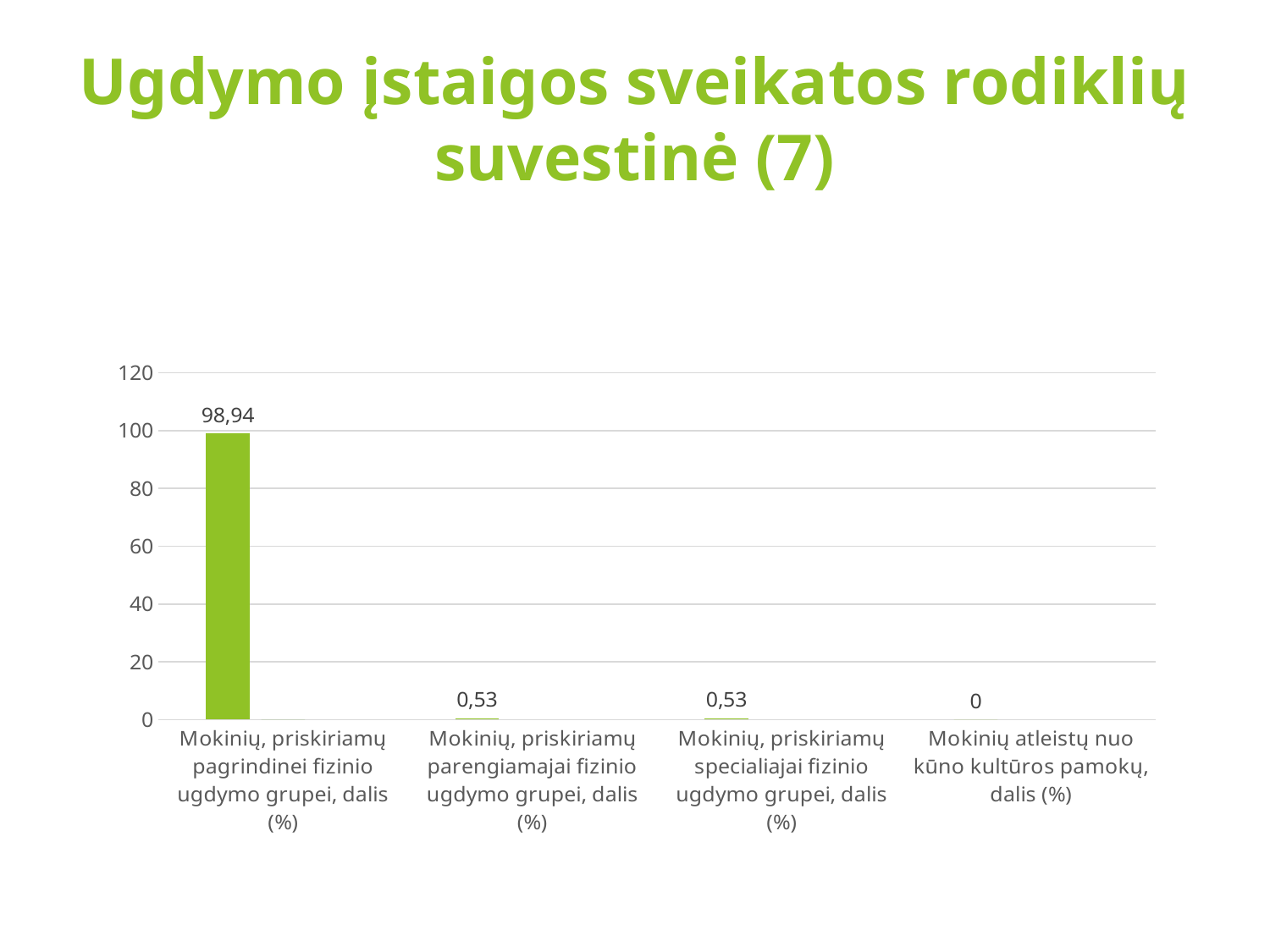
How many categories are shown on the x axis of the chart? 4 Which category has the lowest value? Mokinių atleistų nuo kūno kultūros pamokų, dalis (%) What is the difference between the value for "Mokinių, priskiriamų pagrindinei fizinio ugdymo grupei, dalis (%)" and the value for "Mokinių, priskiriamų parengiamajai fizinio ugdymo grupei, dalis (%)"? 98,41 Is the value for "Mokinių, priskiriamų pagrindinei fizinio ugdymo grupei, dalis (%)" greater or less than 80? greater What is the title of the slide? Ugdymo įstaigos sveikatos rodiklių suvestinė (7) What is the value for "Mokinių, priskiriamų specialiajai fizinio ugdymo grupei, dalis (%)"? 0,53 Which is larger: the value for "Mokinių, priskiriamų specialiajai fizinio ugdymo grupei, dalis (%)" or the value for "Mokinių atleistų nuo kūno kultūros pamokų, dalis (%)"? Mokinių, priskiriamų specialiajai fizinio ugdymo grupei, dalis (%) What is the value for "Mokinių, priskiriamų pagrindinei fizinio ugdymo grupei, dalis (%)"? 98,94 What is the value for "Mokinių, priskiriamų parengiamajai fizinio ugdymo grupei, dalis (%)"? 0,53 Which category has the highest value? Mokinių, priskiriamų pagrindinei fizinio ugdymo grupei, dalis (%) What is the value for "Mokinių atleistų nuo kūno kultūros pamokų, dalis (%)"? 0 What kind of chart is shown on the slide? bar chart